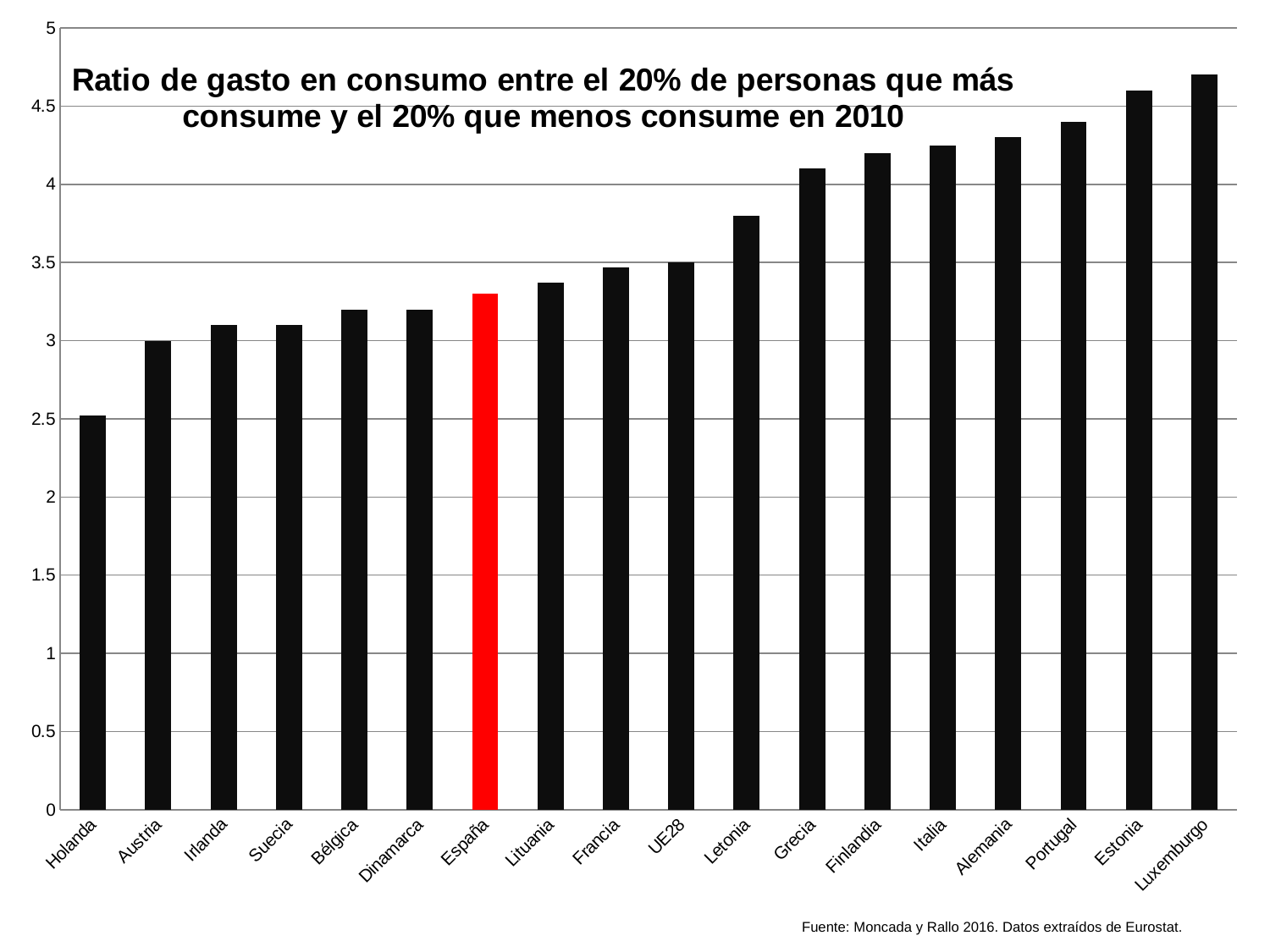
Which country has the highest ratio in the chart? Luxemburgo Is the value for Luxemburgo greater or less than 4.5? greater How many categories are shown on the x axis? 18 Which country's bar is highlighted in red? España Is the value for Holanda greater or less than 3? less Is the value for España greater or less than 3.5? less What kind of chart is shown on the slide? bar chart Which country has the lowest ratio in the chart? Holanda Which has the larger value, Alemania or Irlanda? Alemania Do the values rise or fall from left to right along the x axis? rise What is the value for Austria? 3